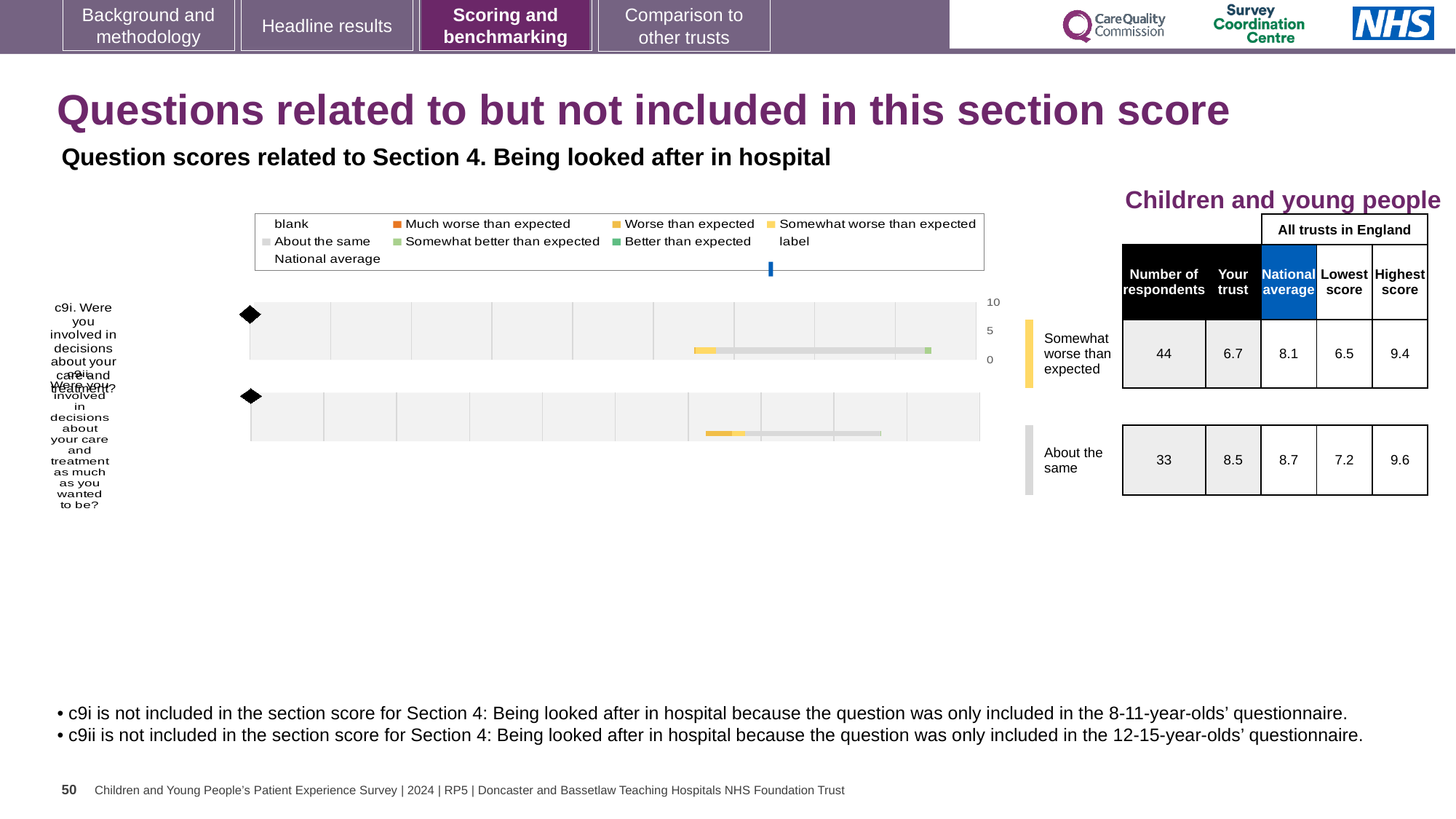
What is the national average score for question c9ii? 8.7 How many respondents answered question c9i? 44 By how much is the national average higher than the trust's score for question c9i? 1.4 What is the difference between the trust's scores for c9ii and c9i? 1.8 Which benchmark category is question c9i placed in? Somewhat worse than expected What is the 'Your trust' score for question c9i? 6.7 Which benchmark category is question c9ii placed in? About the same What kind of chart is used to show the question scores for c9i and c9ii? bar chart What is the lowest score among all trusts in England for question c9i? 6.5 Which question has the higher 'Your trust' score, c9i or c9ii? c9ii How many questions are plotted in the chart? 2 What is the highest score among all trusts in England for question c9ii? 9.6